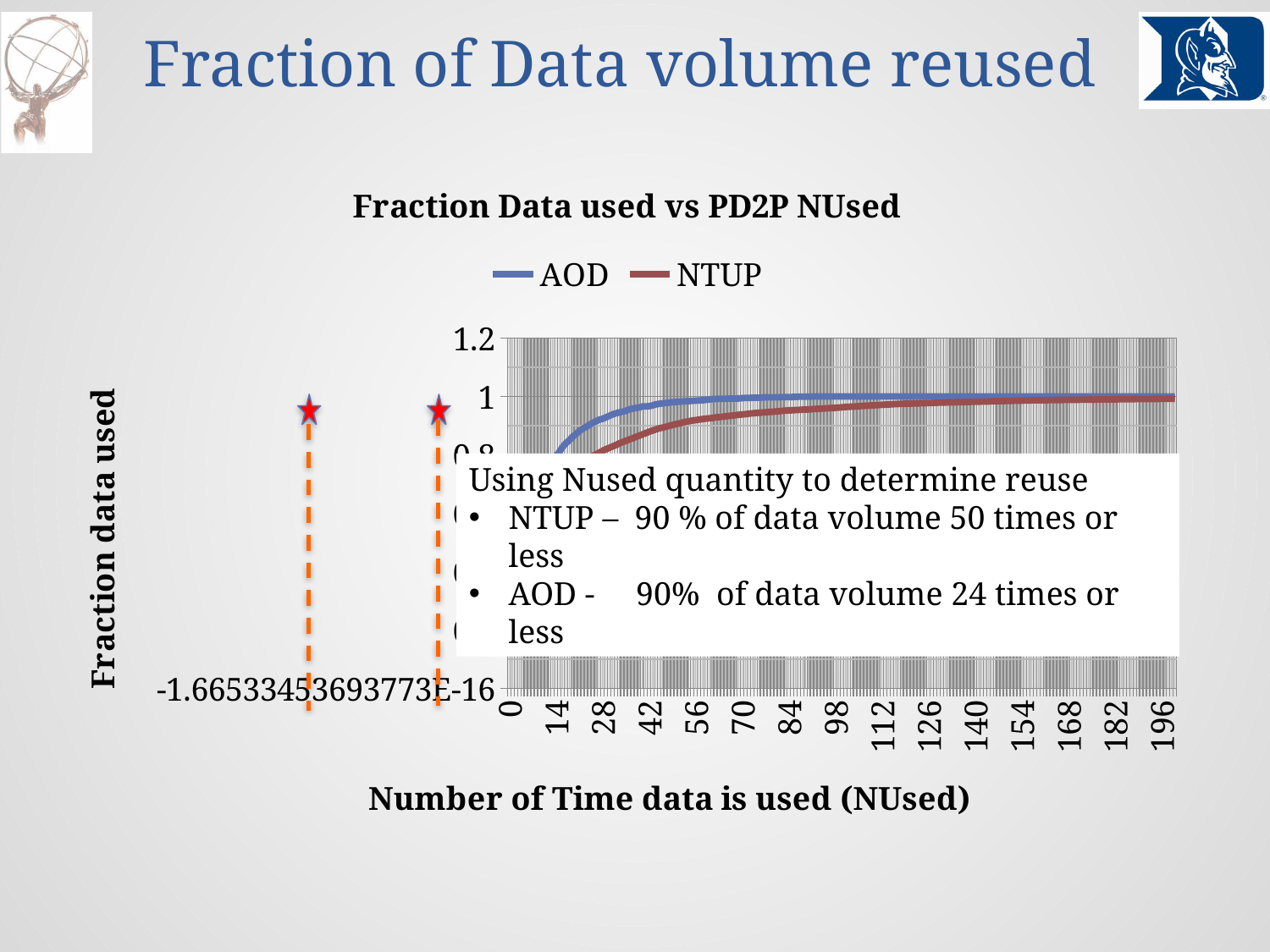
Is the AOD value at NUsed = 56 greater or less than 0.8? greater What are the two series named in the legend? AOD and NTUP What is the largest tick value shown on the x axis? 196 What is the title of the chart? Fraction Data used vs PD2P NUsed Is the NTUP value at NUsed = 196 greater or less than 1.2? less How many series does the legend list? 2 Is the NTUP value at NUsed = 140 greater or less than 0.8? greater Do the AOD and NTUP lines rise or fall as NUsed increases along the x axis? rise At NUsed = 42, which series has the higher fraction of data used, AOD or NTUP? AOD What is the highest tick value shown on the y axis? 1.2 How many tick labels are shown along the x axis? 15 What kind of chart is shown on the slide? line chart